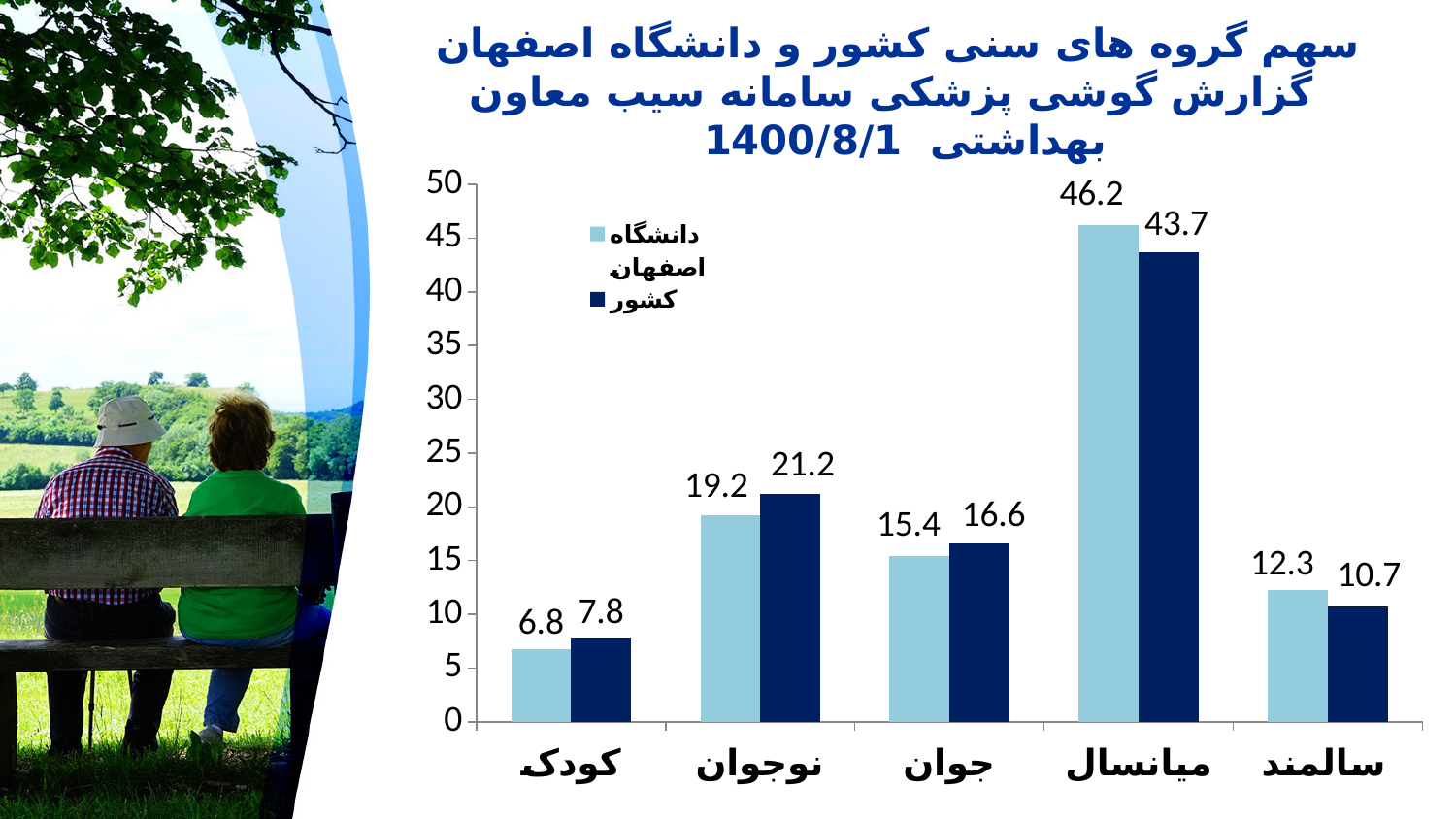
Is the value for کشور in the سالمند category greater or less than 15? less What kind of chart is shown on the slide? bar chart What is the difference between the دانشگاه اصفهان and کشور values in the میانسال category? 2.5 Which category has the lowest value for the دانشگاه اصفهان series? کودک What is the value for دانشگاه اصفهان in the کودک category? 6.8 How many age-group categories are shown on the x axis? 5 What is the value for کشور in the نوجوان category? 21.2 Which category has the highest value for the کشور series? میانسال In the جوان category, which series has the larger value, دانشگاه اصفهان or کشور? کشور Which series is shown in dark blue in the legend? کشور What is the value for دانشگاه اصفهان in the سالمند category? 12.3 How many series does the legend list? 2